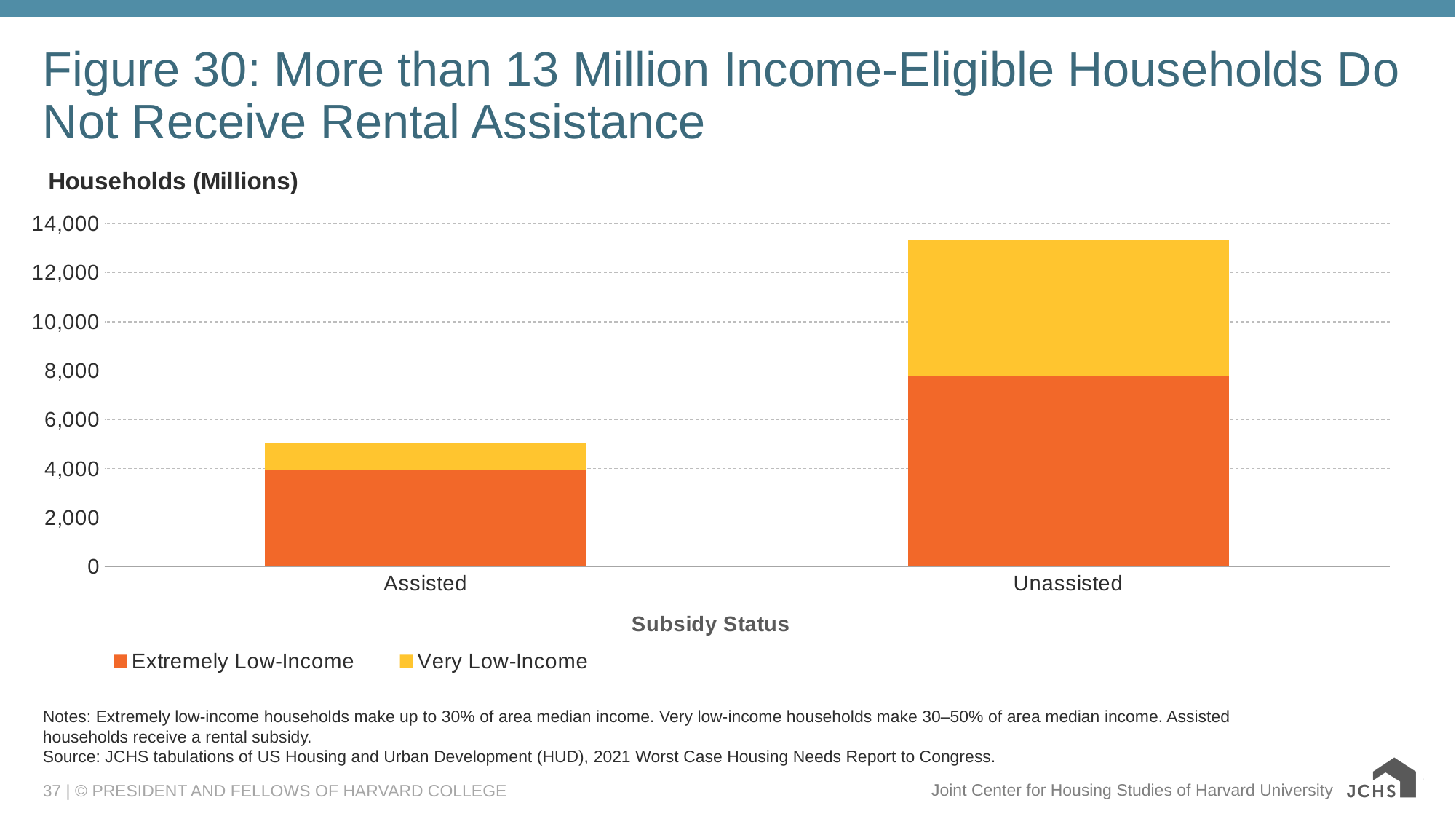
What kind of chart is shown on the slide? Stacked bar chart Within the Unassisted bar, which segment is larger: Extremely Low-Income or Very Low-Income? Extremely Low-Income Is the Very Low-Income segment of the Assisted bar greater or less than 2,000? less How many series does the legend list? 2 Is the total height of the Assisted bar greater or less than 6,000? less Is the Extremely Low-Income segment of the Unassisted bar greater or less than 6,000? greater Which colour represents Very Low-Income households in the legend? Yellow Which subsidy status category has the taller stacked bar? Unassisted Which subsidy status category has the shorter stacked bar? Assisted How many subsidy status categories are shown on the x axis? 2 What is the label of the y axis? Households (Millions)